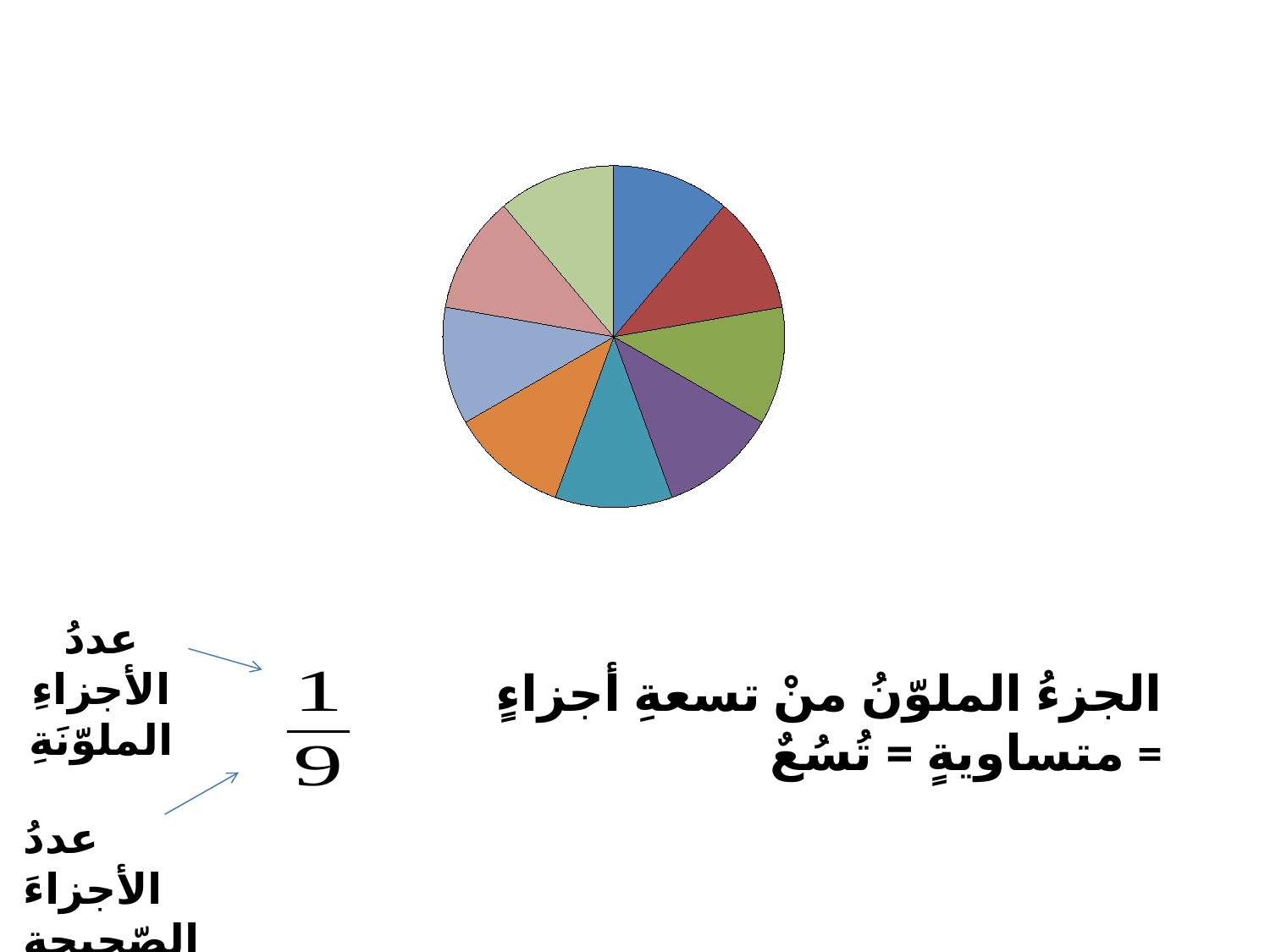
How many slices does the pie chart have? 9 What fraction of the whole pie does one slice represent, as written on the slide? 1/9 Are the slices of the pie chart equal in size or different in size? equal Does the pie chart have a legend? No What kind of chart is shown on the slide? pie chart